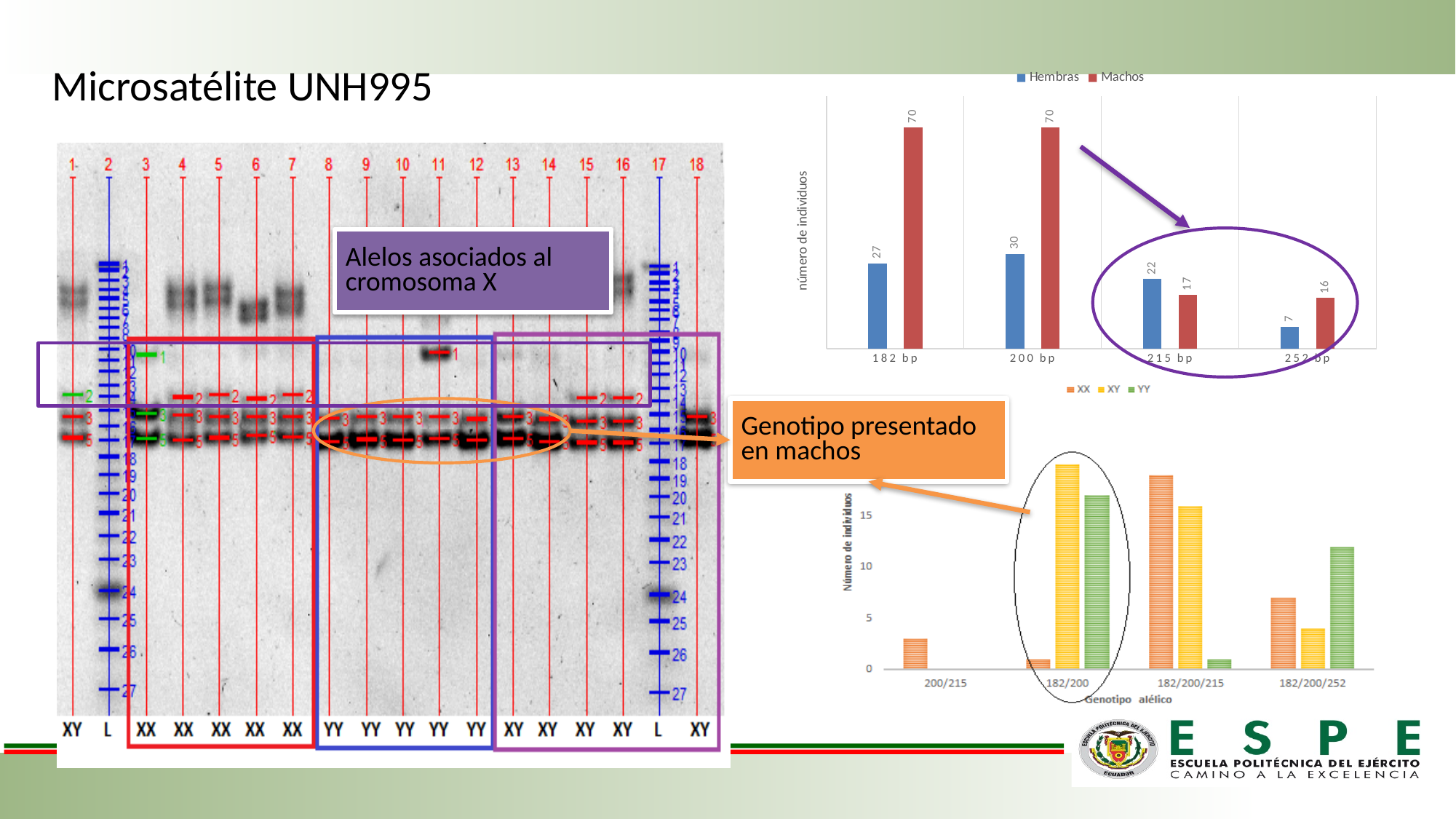
In the top-right chart (Hembras/Machos), what is the difference between Machos and Hembras at 200 bp? 40 What kind of chart is the bottom-right chart (Genotipo alélico)? bar chart In the top-right chart (Hembras/Machos), which is larger at 215 bp, Hembras or Machos? Hembras In the top-right chart (Hembras/Machos), how many series does the legend list? 2 In the top-right chart (Hembras/Machos), what is the value for Hembras at 252 bp? 7 In the bottom-right chart (Genotipo alélico), is the value for XY at 182/200 greater or less than 15? greater In the top-right chart (Hembras/Machos), what is the value for Machos at 182 bp? 70 In the bottom-right chart (Genotipo alélico), is the value for XX at 200/215 greater or less than 5? less In the top-right chart (Hembras/Machos), which category has the lowest Hembras value? 252 bp In the top-right chart (Hembras/Machos), what is the value for Hembras at 215 bp? 22 In the bottom-right chart (Genotipo alélico), how many series does the legend list? 3 In the top-right chart (Hembras/Machos), how many categories are shown on the x axis? 4